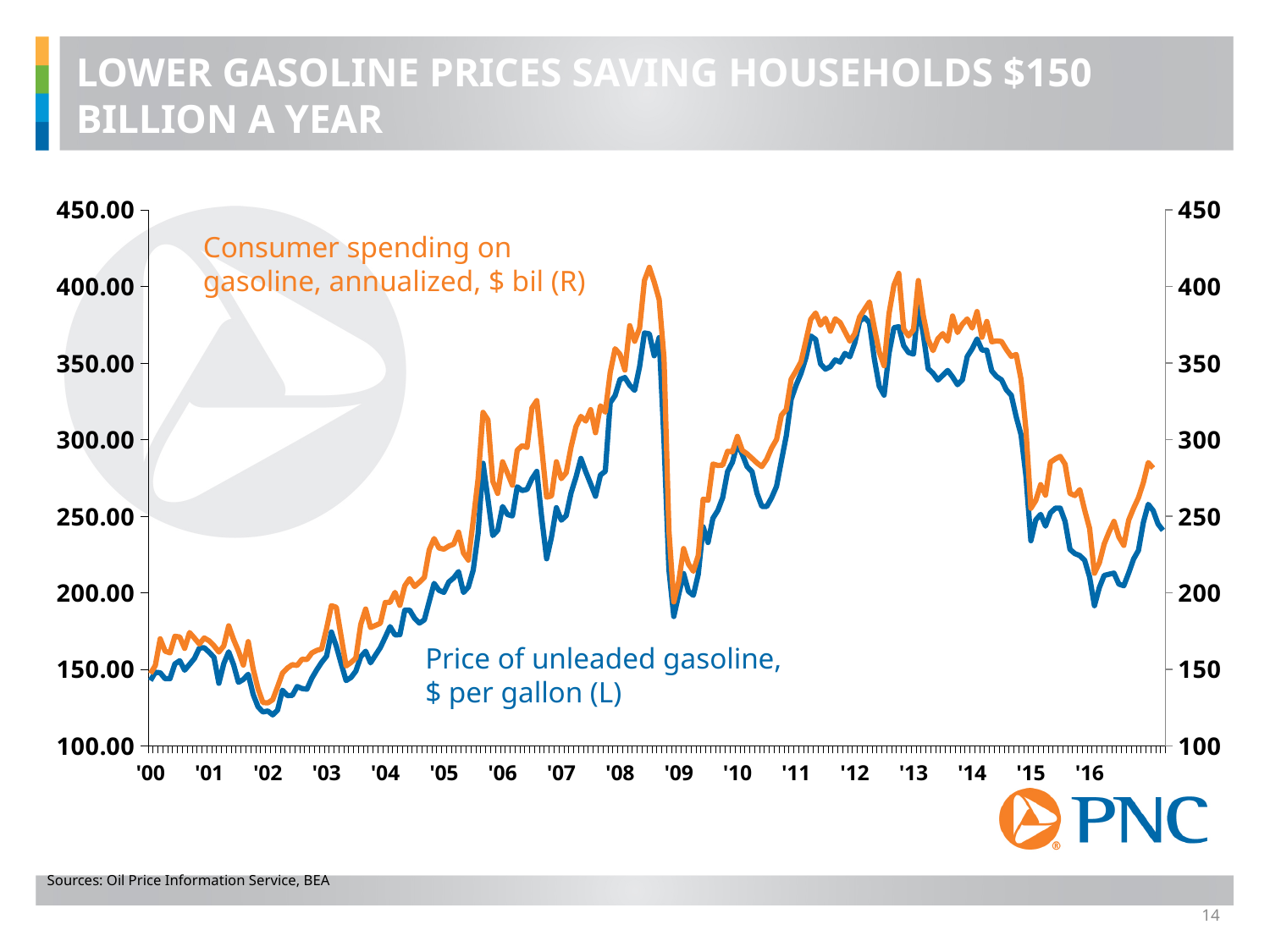
Is the value for the price of unleaded gasoline at '16 greater or less than 250.00? less Which series is plotted against the right-hand axis? Consumer spending on gasoline, annualized, $ bil What is the title of the slide? Lower gasoline prices saving households $150 billion a year How many series are plotted on the chart? 2 Is the value for consumer spending on gasoline at '04 greater or less than 250? less What kind of chart is shown on the slide? Line chart Is the value for the price of unleaded gasoline at '02 greater or less than 150.00? less Does consumer spending on gasoline generally rise or fall between '14 and '16? Fall How many year labels are shown on the x axis? 17 Does the price of unleaded gasoline generally rise or fall between '02 and '08? Rise